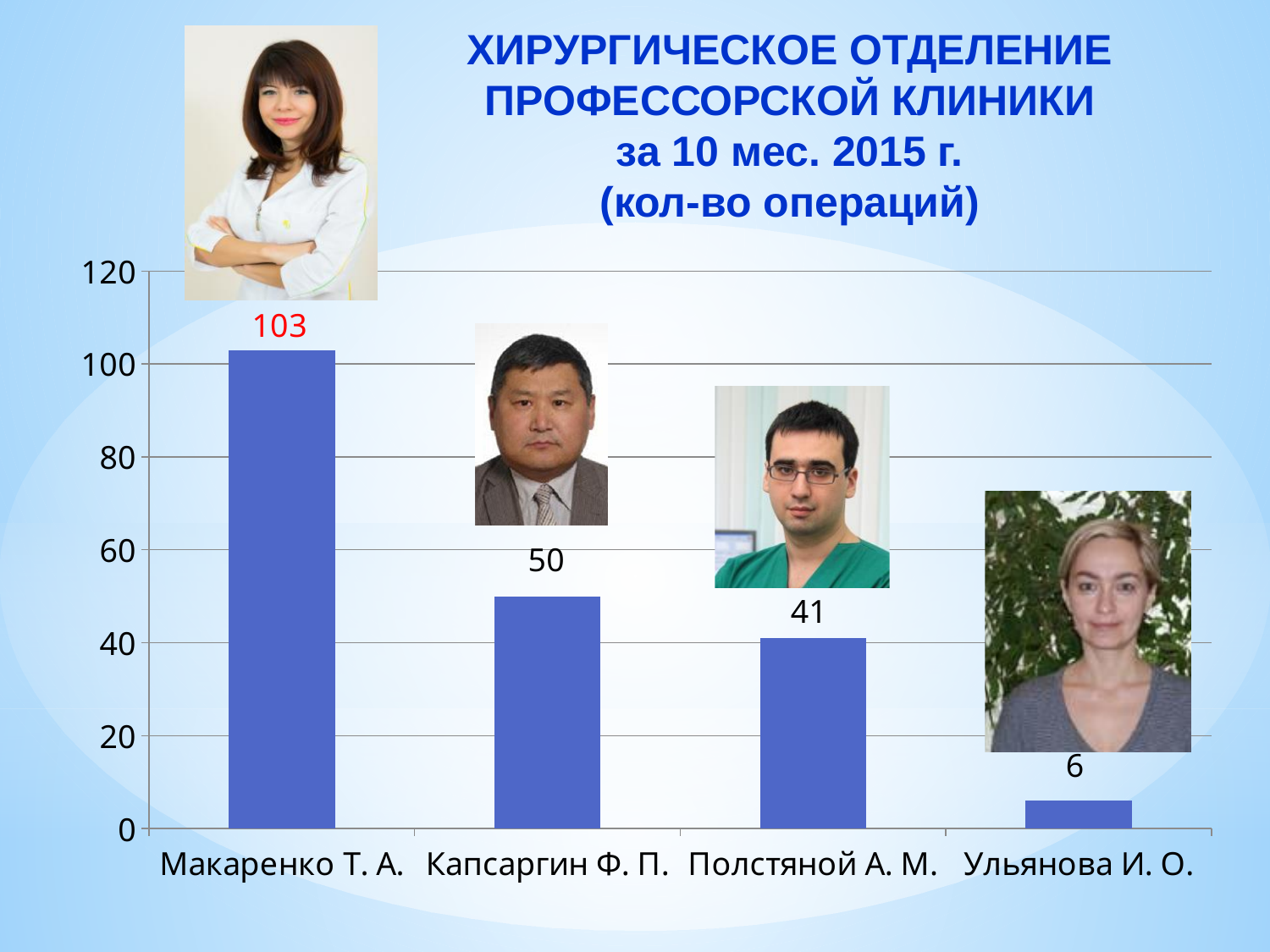
What is the value shown for Капсаргин Ф. П.? 50 Which surgeon has the lowest number of operations? Ульянова И. О. Is the value for Макаренко Т. А. greater or less than 100? greater Who has the larger value, Полстяной А. М. or Ульянова И. О.? Полстяной А. М. What is the difference between the values for Макаренко Т. А. and Капсаргин Ф. П.? 53 Which surgeon has the highest number of operations? Макаренко Т. А. What type of chart is shown on the slide? bar chart What is the value shown for Ульянова И. О.? 6 What is the difference between the values for Капсаргин Ф. П. and Полстяной А. М.? 9 How many operations did Макаренко Т. А. perform? 103 How many surgeons are shown on the chart? 4 What is the value shown for Полстяной А. М.? 41